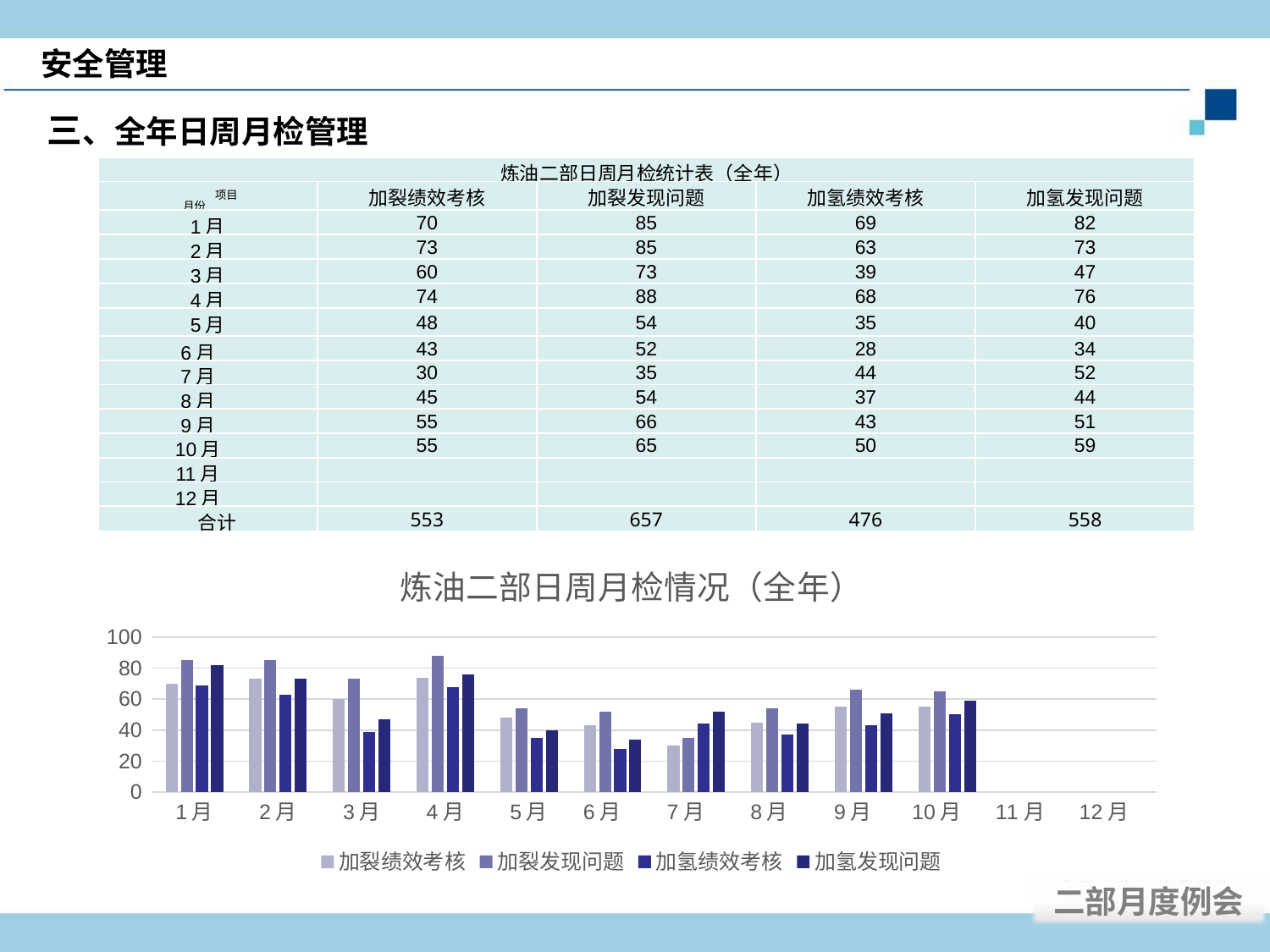
In 3月, which is larger: 加裂发现问题 or 加氢绩效考核? 加裂发现问题 Which month has the highest value for 加裂发现问题? 4月 What is the value of 加裂绩效考核 for 5月? 48 How many month categories are shown on the x axis of the chart? 12 Which month has the lowest value for 加氢绩效考核? 6月 Does the value of 加裂绩效考核 rise or fall from 4月 to 7月? fall What is the title of the chart? 炼油二部日周月检情况（全年） Is the value of 加裂发现问题 for 1月 greater or less than 80? greater How many series does the chart legend list? 4 What is the value of 加氢发现问题 for 10月? 59 Which months on the chart have no bars plotted? 11月 and 12月 What kind of chart is shown on the slide? bar chart